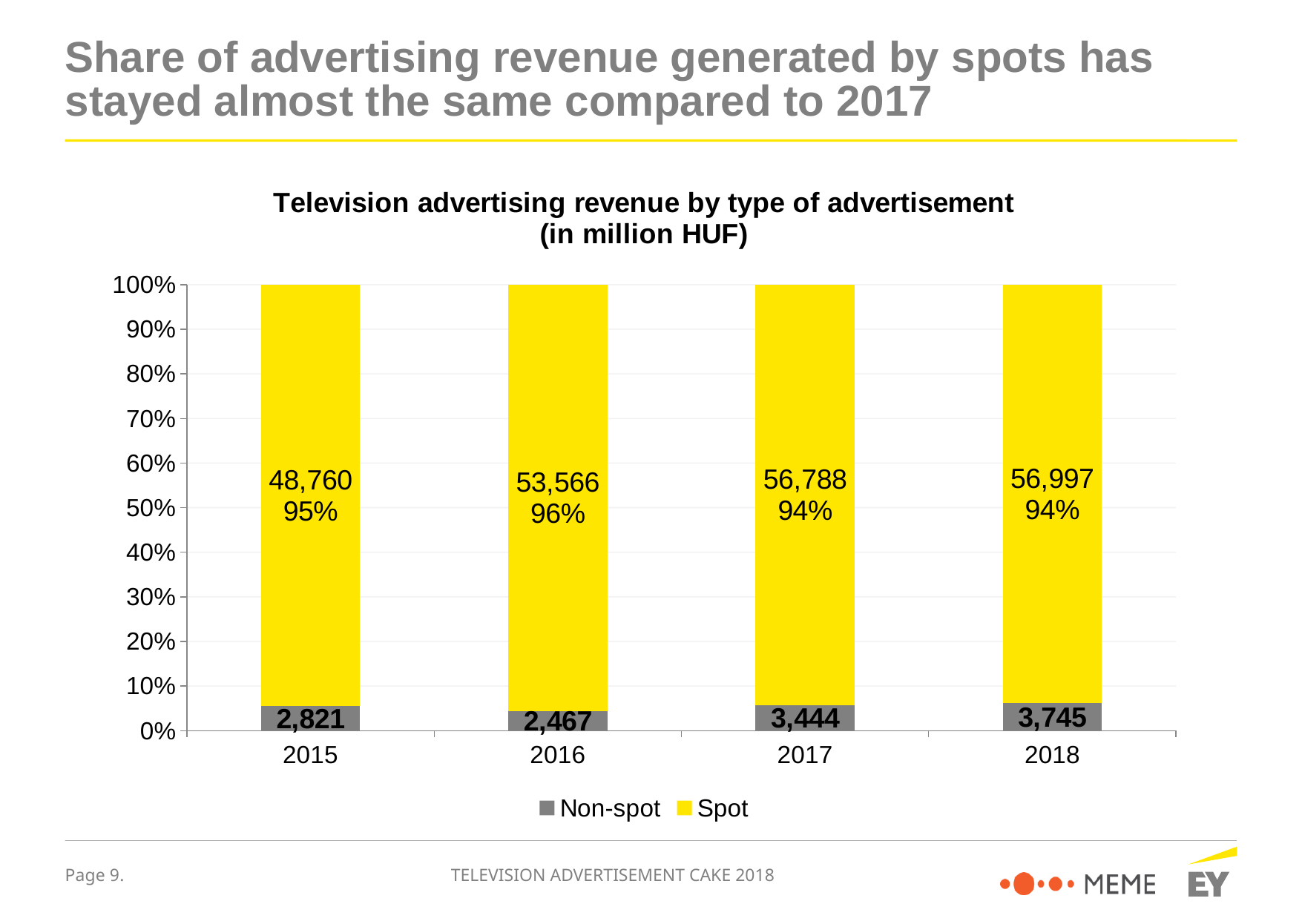
How many years are shown on the x axis? 4 What is the Non-spot revenue for 2018? 3,745 Which year has the lowest Spot revenue? 2015 Which year has the highest Non-spot revenue? 2018 What kind of chart is shown on the slide? Stacked bar chart What is the total television advertising revenue (Spot plus Non-spot) in 2016? 56,033 Which is larger, the Spot revenue in 2017 or in 2018? 2018 How many series does the legend list? 2 What share of revenue did Spot advertising account for in 2015? 95% Which colour represents the Spot series in the chart? Yellow What is the difference between the Non-spot revenue in 2018 and in 2017? 301 What is the Spot revenue for 2016? 53,566